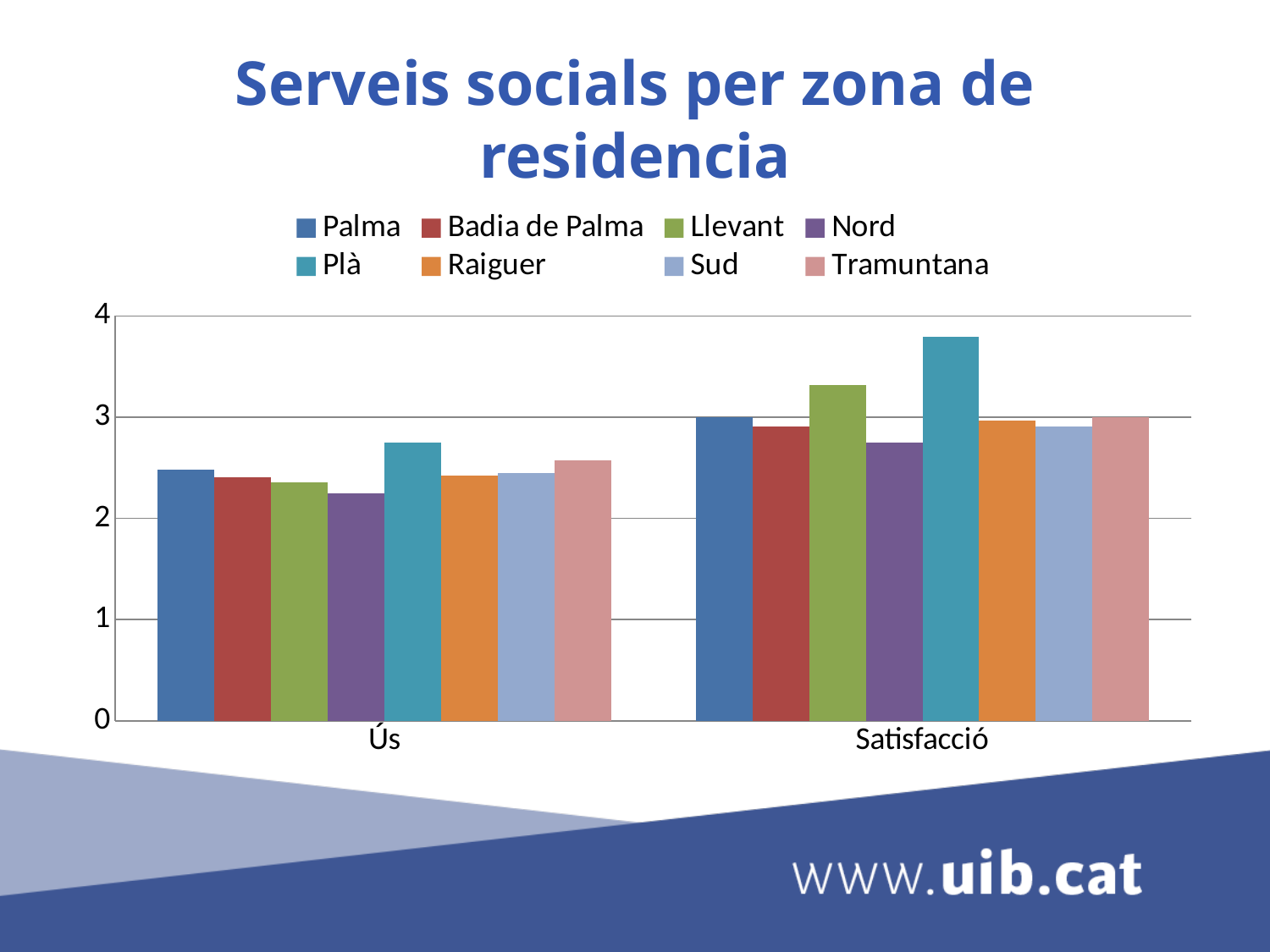
Which zone has the highest value for Ús? Plà Which zone has the highest value for Satisfacció? Plà Is the value for Nord in Satisfacció greater or less than 3? less For Ús, which is larger: the value for Plà or the value for Palma? Plà Is the value for Nord in Ús greater or less than 2? greater Which zone has the lowest value for Ús? Nord How many series does the legend list? 8 Which zone has the lowest value for Satisfacció? Nord What is the title of the chart on the slide? Serveis socials per zona de residencia Is the value for Plà in Satisfacció greater or less than 3? greater How many categories are shown on the x axis? 2 What kind of chart is shown on the slide? bar chart